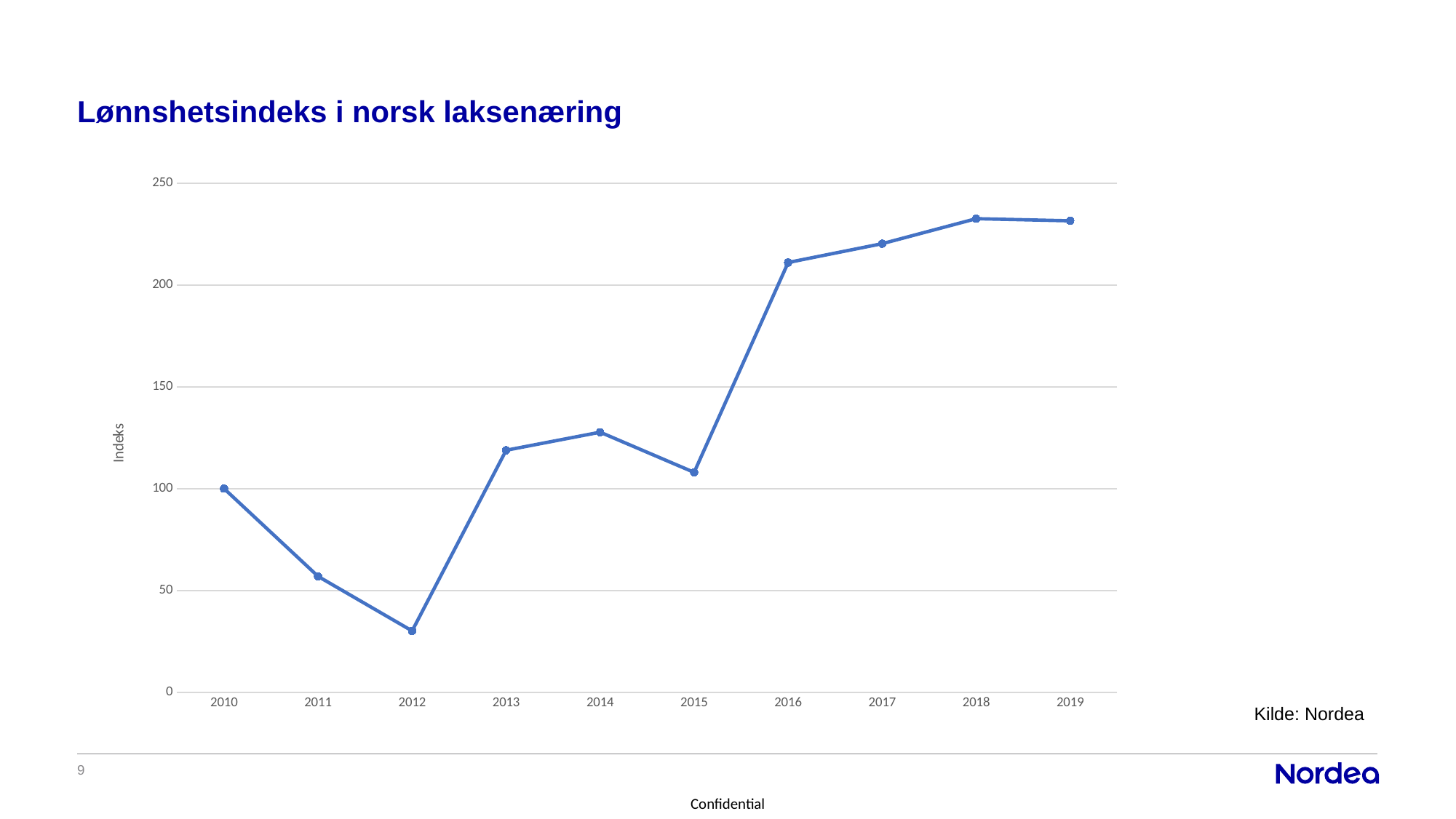
What is the label on the vertical axis? Indeks How many years are plotted on the x axis? 10 What kind of chart is shown on the slide? line chart Is the value for 2012 greater or less than 50? less Is the value for 2014 greater or less than 150? less Is the value for 2018 greater or less than 250? less Which year has the lowest index value? 2012 What is the title of the chart? Lønnshetsindeks i norsk laksenæring Does the index generally rise or fall from 2010 to 2019? rise What is the index value for 2010? 100 Which is larger, the value for 2013 or the value for 2015? 2013